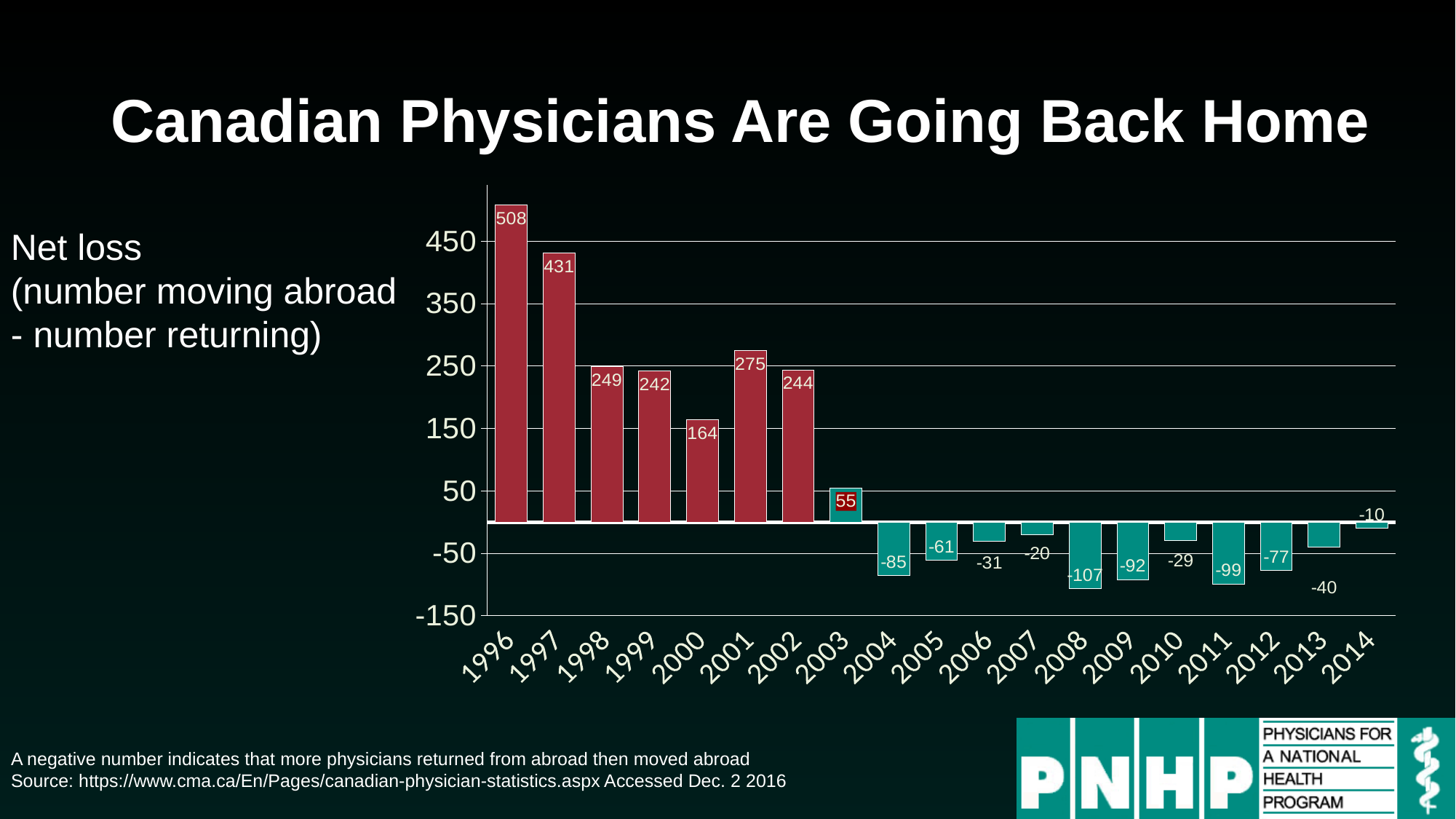
What is the title of the slide containing the chart? Canadian Physicians Are Going Back Home Do the net loss values generally rise or fall from 1996 to 2014? Fall Which year has the larger net loss value, 2001 or 2002? 2001 Which year has the highest net loss value? 1996 Which year has the lowest net loss value? 2008 What kind of chart is shown on the slide? Bar chart What is the net loss value for 1996? 508 How many years are shown on the x axis? 19 What is the net loss value for 2003? 55 What is the difference between the net loss values for 1996 and 1997? 77 What is the net loss value for 2008? -107 What is the net loss value for 2014? -10